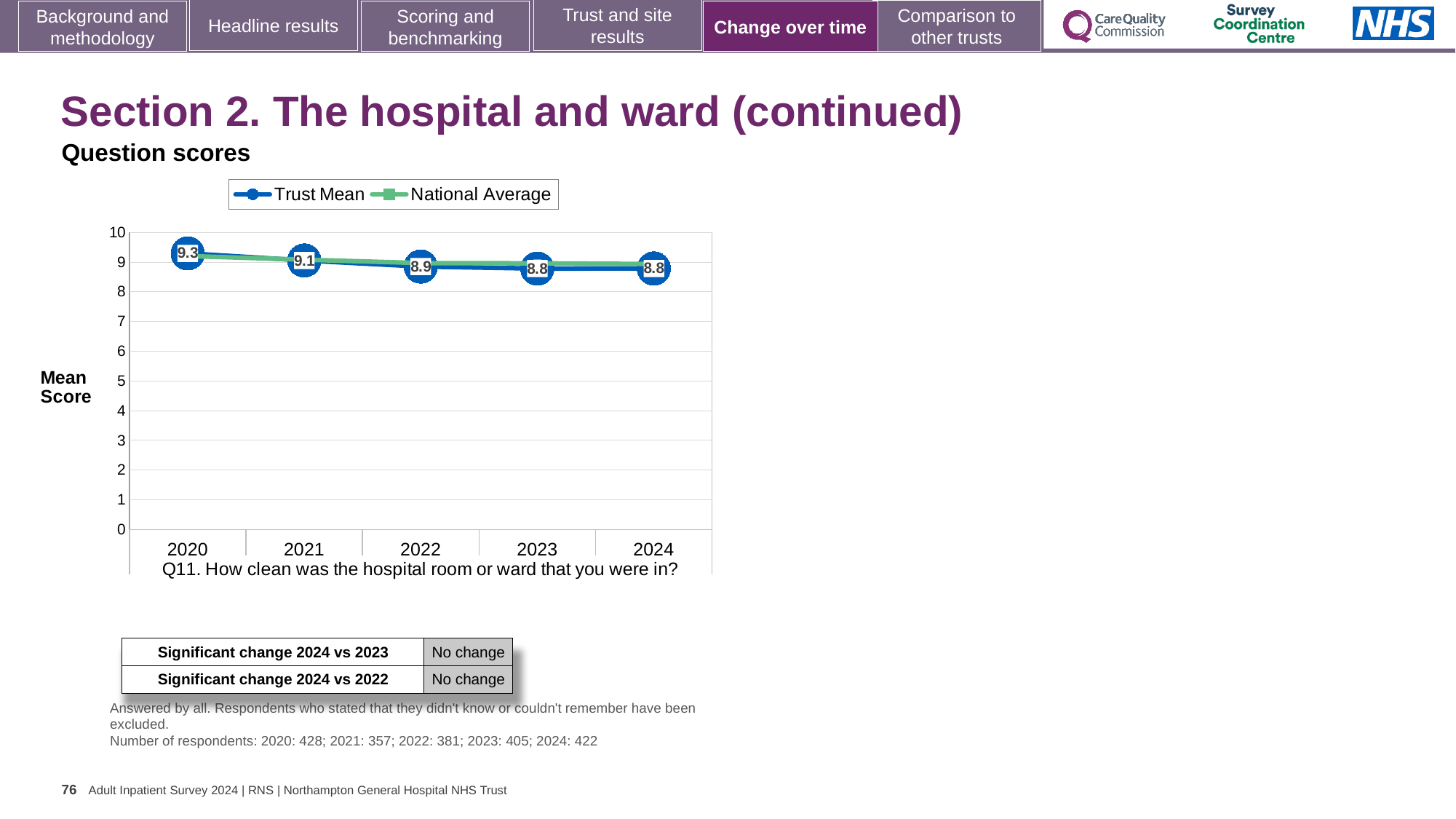
What kind of chart is shown? line chart What is the label on the y axis? Mean Score Does the Trust Mean rise or fall from 2020 to 2024? fall What is the difference between the Trust Mean in 2020 and in 2024? 0.5 What is the Trust Mean for 2022? 8.9 How many series does the legend list? 2 What is the Trust Mean for 2020? 9.3 What is the Trust Mean for 2024? 8.8 In which year is the Trust Mean highest? 2020 Is the National Average for 2024 greater or less than 8? greater Which is larger, the Trust Mean for 2021 or for 2023? 2021 How many years are shown on the x axis? 5